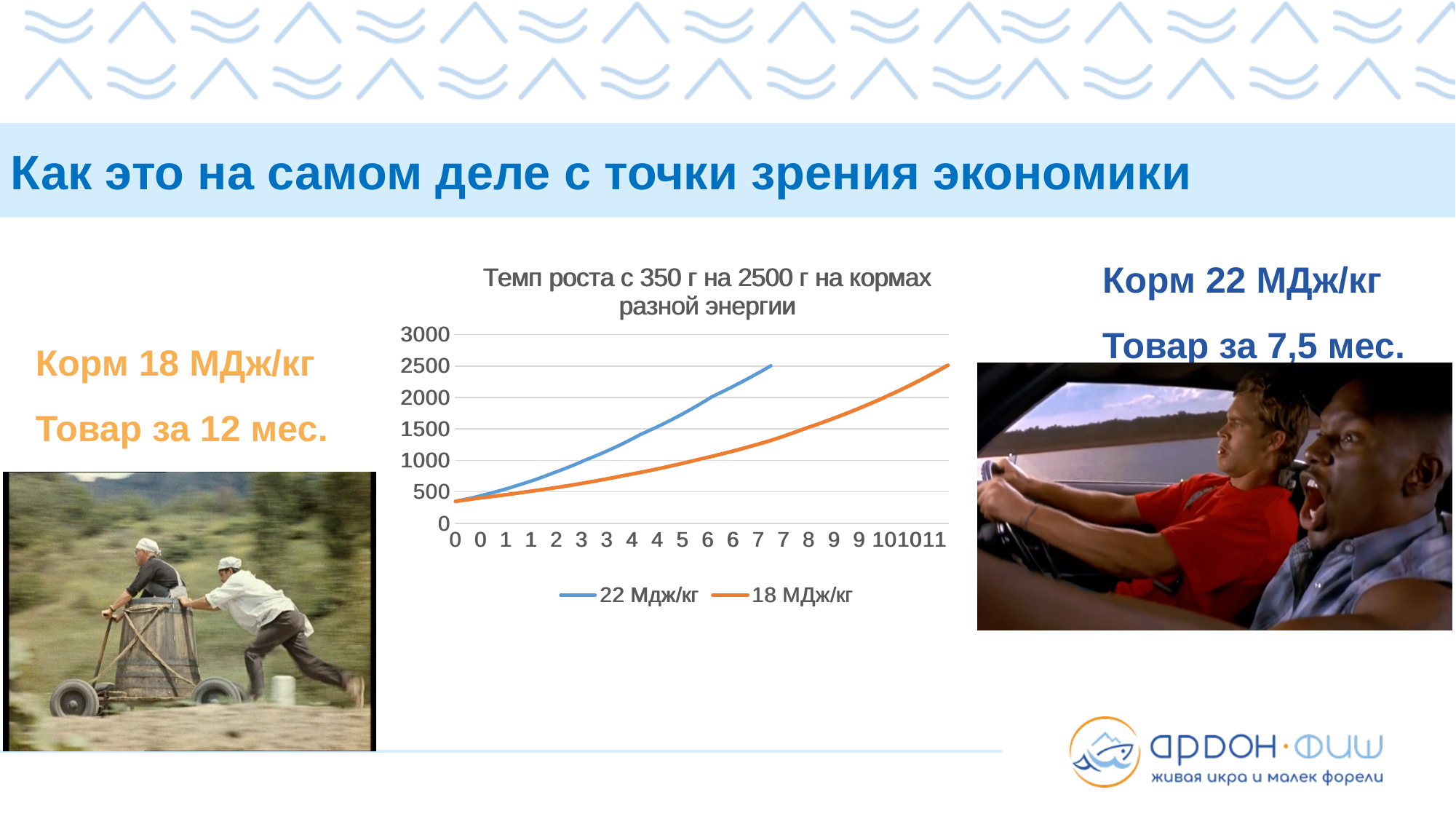
Is the value of the 18 МДж/кг series at the x-axis label 9 greater or less than 1500? greater How many series does the chart legend list? 2 Is the value of the 22 Мдж/кг series at the x-axis label 4 greater or less than 1000? greater Do the values of the 18 МДж/кг series rise or fall along the x axis? rise At the x-axis label 5, which series has the higher value, 22 Мдж/кг or 18 МДж/кг? 22 Мдж/кг Which series reaches 2500 at a smaller x value, 22 Мдж/кг or 18 МДж/кг? 22 Мдж/кг What is the highest value shown on the chart's y axis? 3000 Do the values of the 22 Мдж/кг series rise or fall along the x axis? rise What is the title of the chart? Темп роста с 350 г на 2500 г на кормах разной энергии What are the two series named in the chart legend? 22 Мдж/кг and 18 МДж/кг What kind of chart is shown on the slide? line chart